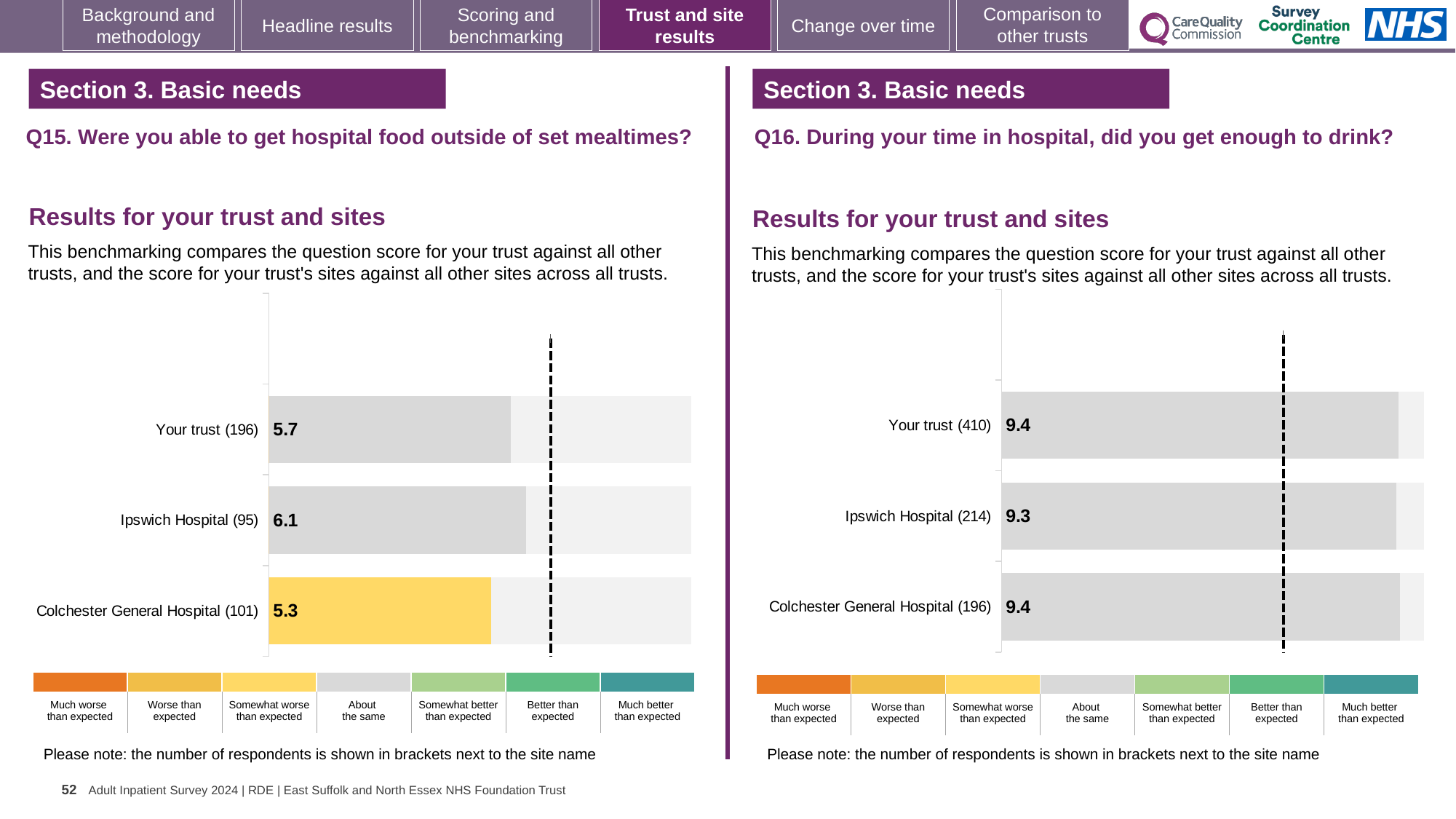
In the Q15 chart (left), what is the score for Your trust? 5.7 In the Q16 chart (right), what is the score for Colchester General Hospital? 9.4 In the Q16 chart (right), how many bars are plotted? 3 In the Q15 chart (left), which site or trust has the lowest score? Colchester General Hospital In the Q16 chart (right), how many respondents are shown in brackets for Your trust? 410 In the Q15 chart (left), what is the difference between the scores for Ipswich Hospital and Colchester General Hospital? 0.8 In the Q15 chart (left), what is the score for Colchester General Hospital? 5.3 In the Q15 chart (left), which site or trust has the highest score? Ipswich Hospital In the Q15 chart (left), which benchmark category does the coloured bar for Colchester General Hospital fall into according to the legend? Somewhat worse than expected What kind of chart is used in the Q15 chart (left)? Bar chart In the Q15 chart (left), what is the score for Ipswich Hospital? 6.1 In the Q16 chart (right), what is the score for Ipswich Hospital? 9.3